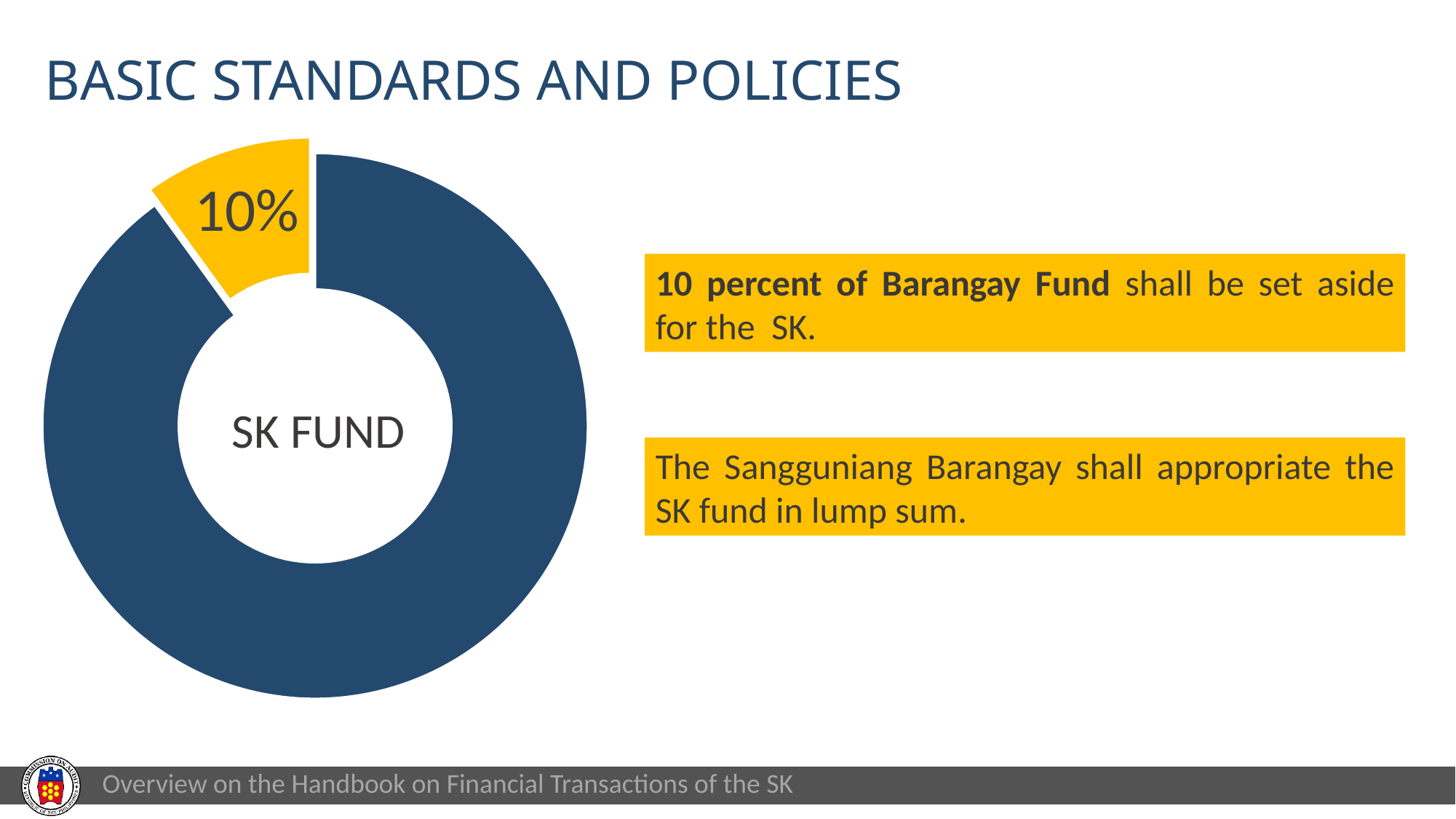
What kind of chart is shown on the slide? doughnut chart How many slices does the doughnut chart have? 2 Is the share of the yellow slice greater or less than 50%? less What share of the doughnut chart does the yellow slice represent? 10% What percentage is printed on the yellow slice of the doughnut chart? 10% What text is written in the centre of the doughnut chart? SK FUND Which slice of the doughnut chart is the smallest? the yellow slice (10%) What colour is the slice labelled 10%? yellow Which slice of the doughnut chart is larger, the yellow one or the dark blue one? the dark blue one